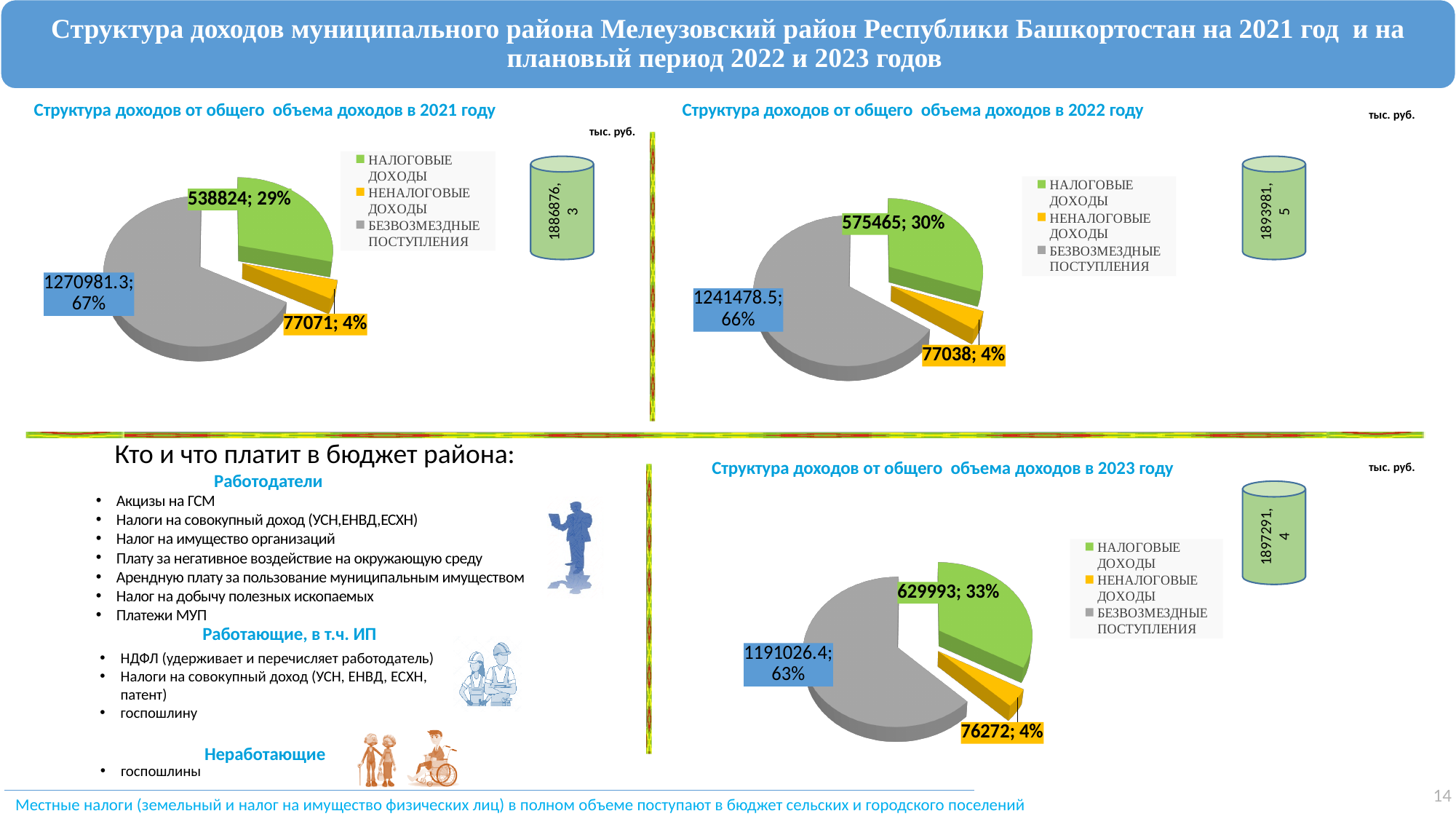
In the chart 'Структура доходов от общего объема доходов в 2021 году', what share of the pie is БЕЗВОЗМЕЗДНЫЕ ПОСТУПЛЕНИЯ? 67% In the chart 'Структура доходов от общего объема доходов в 2021 году', what value is shown for НАЛОГОВЫЕ ДОХОДЫ? 538824 How many categories does the legend of the chart 'Структура доходов от общего объема доходов в 2022 году' list? 3 In the chart 'Структура доходов от общего объема доходов в 2022 году', which category has the largest slice? БЕЗВОЗМЕЗДНЫЕ ПОСТУПЛЕНИЯ In the chart 'Структура доходов от общего объема доходов в 2022 году', what share of the pie is НАЛОГОВЫЕ ДОХОДЫ? 30% In the chart 'Структура доходов от общего объема доходов в 2023 году', which is larger: НАЛОГОВЫЕ ДОХОДЫ or НЕНАЛОГОВЫЕ ДОХОДЫ? НАЛОГОВЫЕ ДОХОДЫ In the chart 'Структура доходов от общего объема доходов в 2021 году', which category has the smallest slice? НЕНАЛОГОВЫЕ ДОХОДЫ In the chart 'Структура доходов от общего объема доходов в 2023 году', what value is shown for БЕЗВОЗМЕЗДНЫЕ ПОСТУПЛЕНИЯ? 1191026.4 In the chart 'Структура доходов от общего объема доходов в 2023 году', what is the difference between the values for НАЛОГОВЫЕ ДОХОДЫ and НЕНАЛОГОВЫЕ ДОХОДЫ? 553721 In the chart 'Структура доходов от общего объема доходов в 2023 году', what share of the pie is НАЛОГОВЫЕ ДОХОДЫ? 33% In the chart 'Структура доходов от общего объема доходов в 2022 году', what value is shown for НЕНАЛОГОВЫЕ ДОХОДЫ? 77038 What type of chart is 'Структура доходов от общего объема доходов в 2021 году'? Pie chart